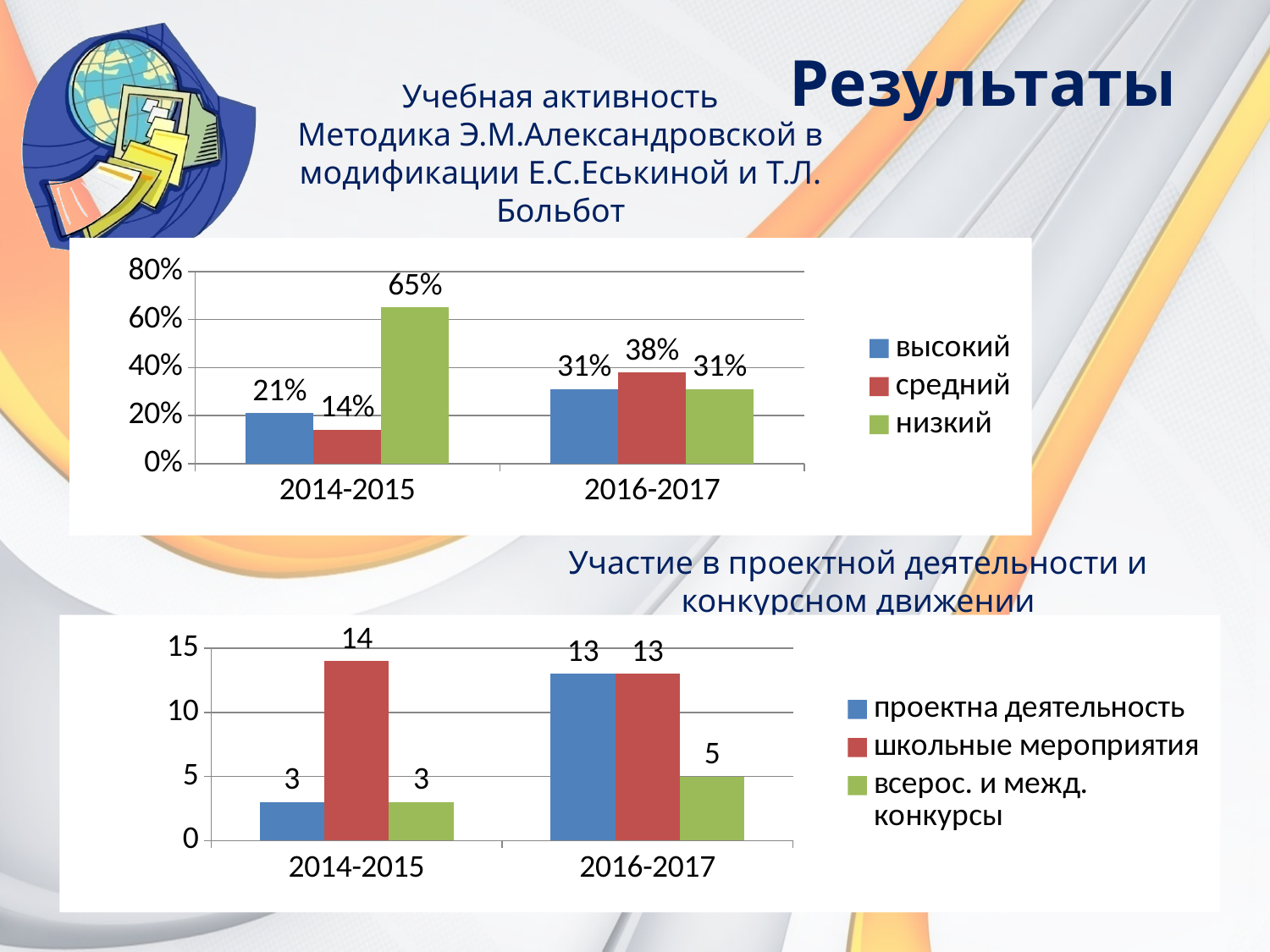
In the bottom chart (Участие в проектной деятельности и конкурсном движении), what is the value for всерос. и межд. конкурсы in 2016-2017? 5 In the top chart (Учебная активность), what is the value for средний in 2016-2017? 38% In the top chart (Учебная активность), what is the difference between the высокий values for 2016-2017 and 2014-2015? 10% In the top chart (Учебная активность), how many series does the legend list? 3 In the bottom chart (Участие в проектной деятельности и конкурсном движении), what is the value for школьные мероприятия in 2014-2015? 14 In the top chart (Учебная активность), which series has the lowest value in 2014-2015? средний In the top chart (Учебная активность), what is the value for низкий in 2014-2015? 65% In the bottom chart (Участие в проектной деятельности и конкурсном движении), which series has the highest value in 2014-2015? школьные мероприятия In the bottom chart (Участие в проектной деятельности и конкурсном движении), what is the difference between проектна деятельность in 2016-2017 and in 2014-2015? 10 What kind of chart is the bottom chart (Участие в проектной деятельности и конкурсном движении)? bar chart In the top chart (Учебная активность), does the value for высокий rise or fall from 2014-2015 to 2016-2017? rise In the bottom chart (Участие в проектной деятельности и конкурсном движении), which is larger: проектна деятельность in 2016-2017 or всерос. и межд. конкурсы in 2016-2017? проектна деятельность